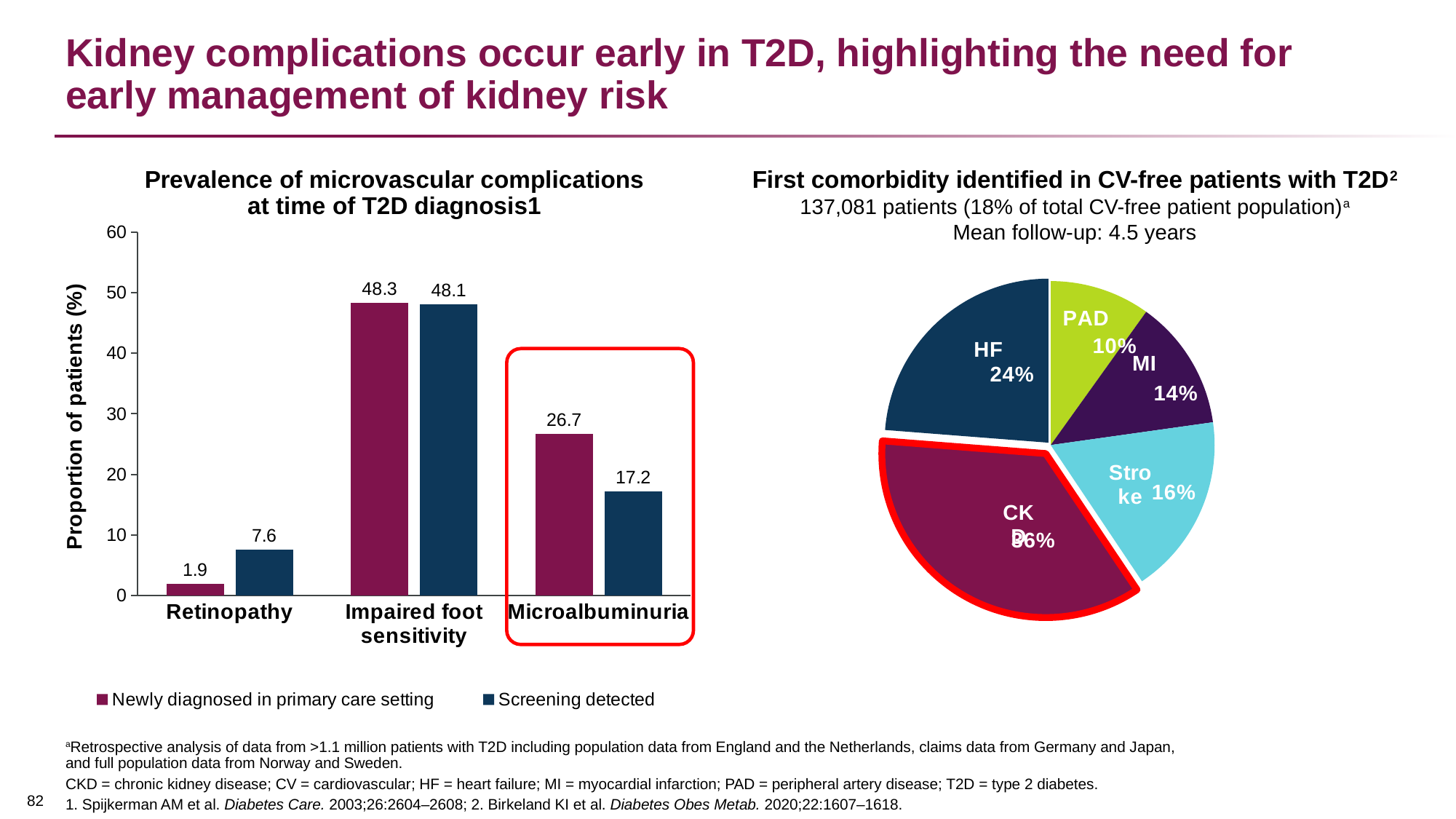
In the bar chart on the left, what is the value for Retinopathy in the 'Screening detected' series? 7.6 In the bar chart on the left, which is larger for Retinopathy: the 'Newly diagnosed in primary care setting' value or the 'Screening detected' value? Screening detected In the bar chart on the left, what is the value for Microalbuminuria in the 'Newly diagnosed in primary care setting' series? 26.7 In the bar chart on the left, what is the value for Impaired foot sensitivity in the 'Newly diagnosed in primary care setting' series? 48.3 How many series does the legend of the bar chart on the left list? 2 In the bar chart on the left, which category has the lowest value in the 'Newly diagnosed in primary care setting' series? Retinopathy In the pie chart on the right, what share is shown for HF? 24% In the pie chart on the right, which comorbidity has the smallest slice? PAD In the pie chart on the right, what share is shown for CKD? 36% In the bar chart on the left, what is the difference between the 'Newly diagnosed in primary care setting' and 'Screening detected' values for Microalbuminuria? 9.5 How many slices does the pie chart on the right have? 5 What kind of chart is the chart on the left of the slide? Bar chart